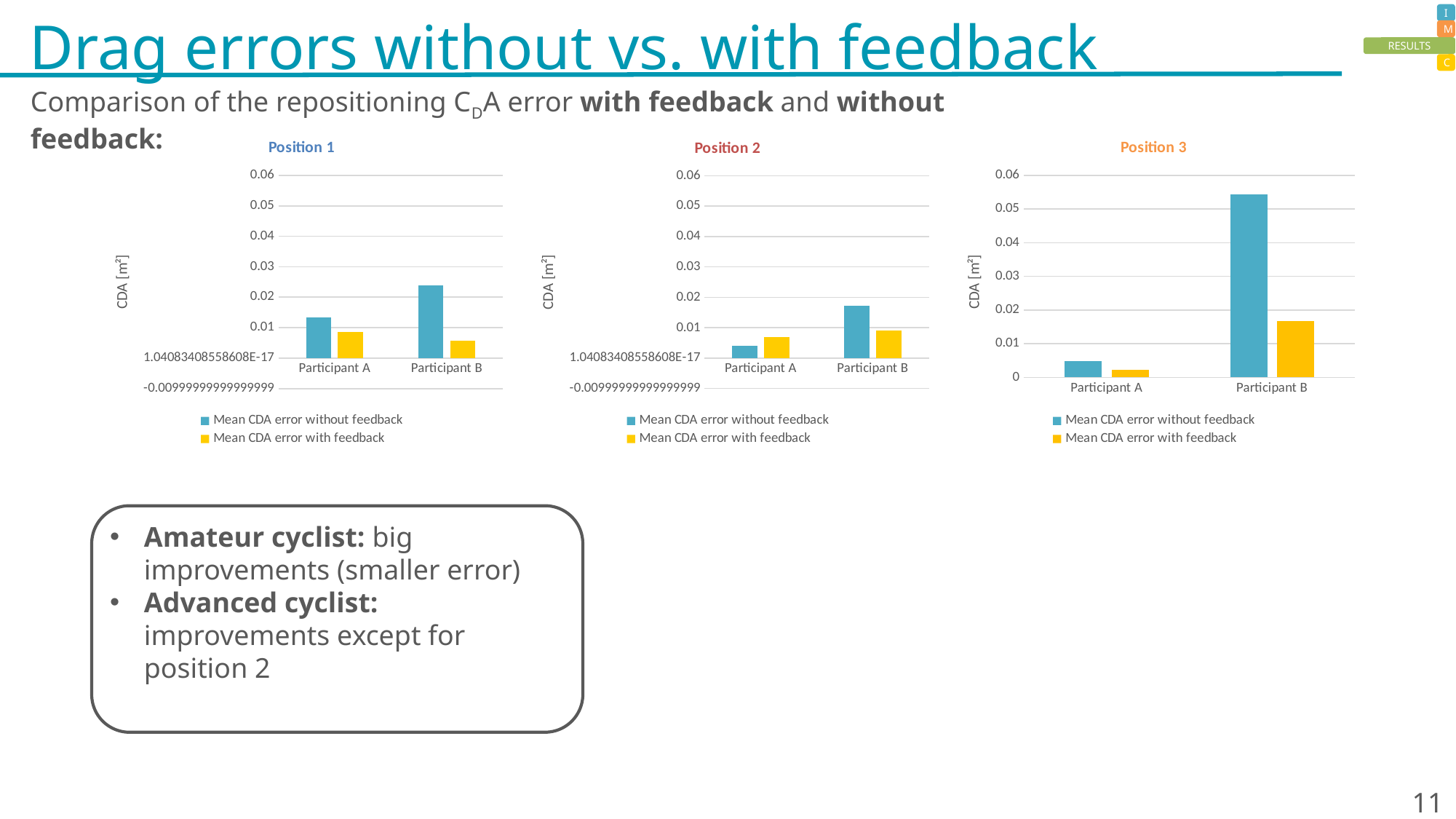
In the Position 1 chart, for Participant B, which is larger: the mean CDA error without feedback or with feedback? without feedback In the Position 3 chart, is the mean CDA error without feedback for Participant A greater or less than 0.01? less In the Position 3 chart, is the mean CDA error with feedback for Participant B greater or less than 0.01? greater In the Position 3 chart, is the mean CDA error without feedback for Participant B greater or less than 0.05? greater What kind of chart is the Position 3 chart? bar chart How many series does the legend of the Position 2 chart list? 2 In the Position 2 chart, for Participant A, which is larger: the mean CDA error without feedback or with feedback? with feedback In the Position 3 chart, which participant has the higher mean CDA error without feedback? Participant B How many participants are shown on the x axis of the Position 1 chart? 2 What is the y-axis label of the Position 1 chart? CDA [m²]